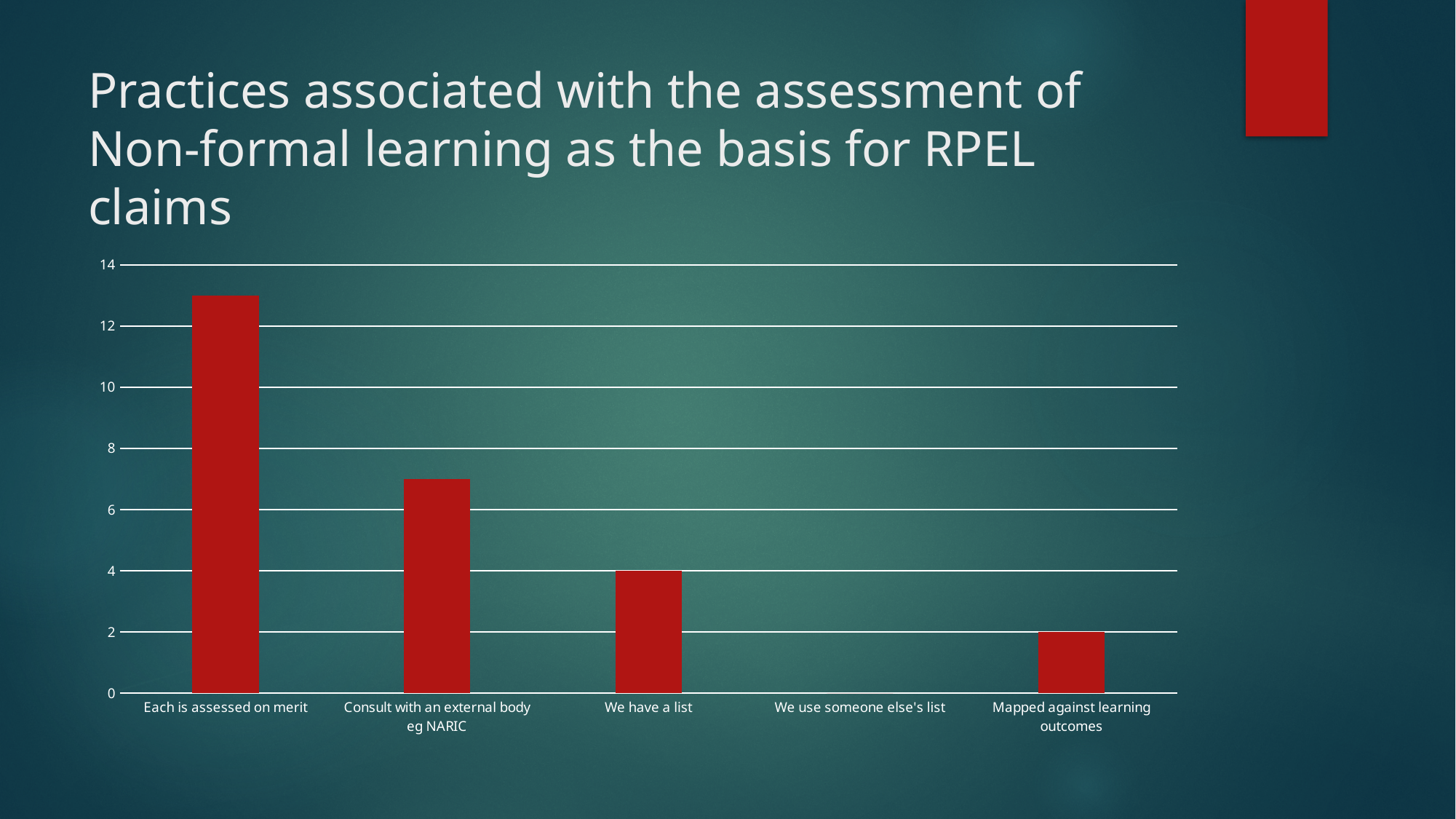
Is the value for "Each is assessed on merit" greater or less than 12? greater Which category has the highest value? Each is assessed on merit What is the value for "We have a list"? 4 Is the value for "Consult with an external body eg NARIC" greater or less than 8? less Which category has the lowest value? We use someone else's list What is the difference between the values for "We have a list" and "Mapped against learning outcomes"? 2 What is the value for "We use someone else's list"? 0 What is the title of the slide containing the chart? Practices associated with the assessment of Non-formal learning as the basis for RPEL claims How many categories are shown on the x axis of the chart? 5 What kind of chart is shown on the slide? bar chart What is the value for "Mapped against learning outcomes"? 2 Which is larger, the value for "Consult with an external body eg NARIC" or the value for "We have a list"? Consult with an external body eg NARIC